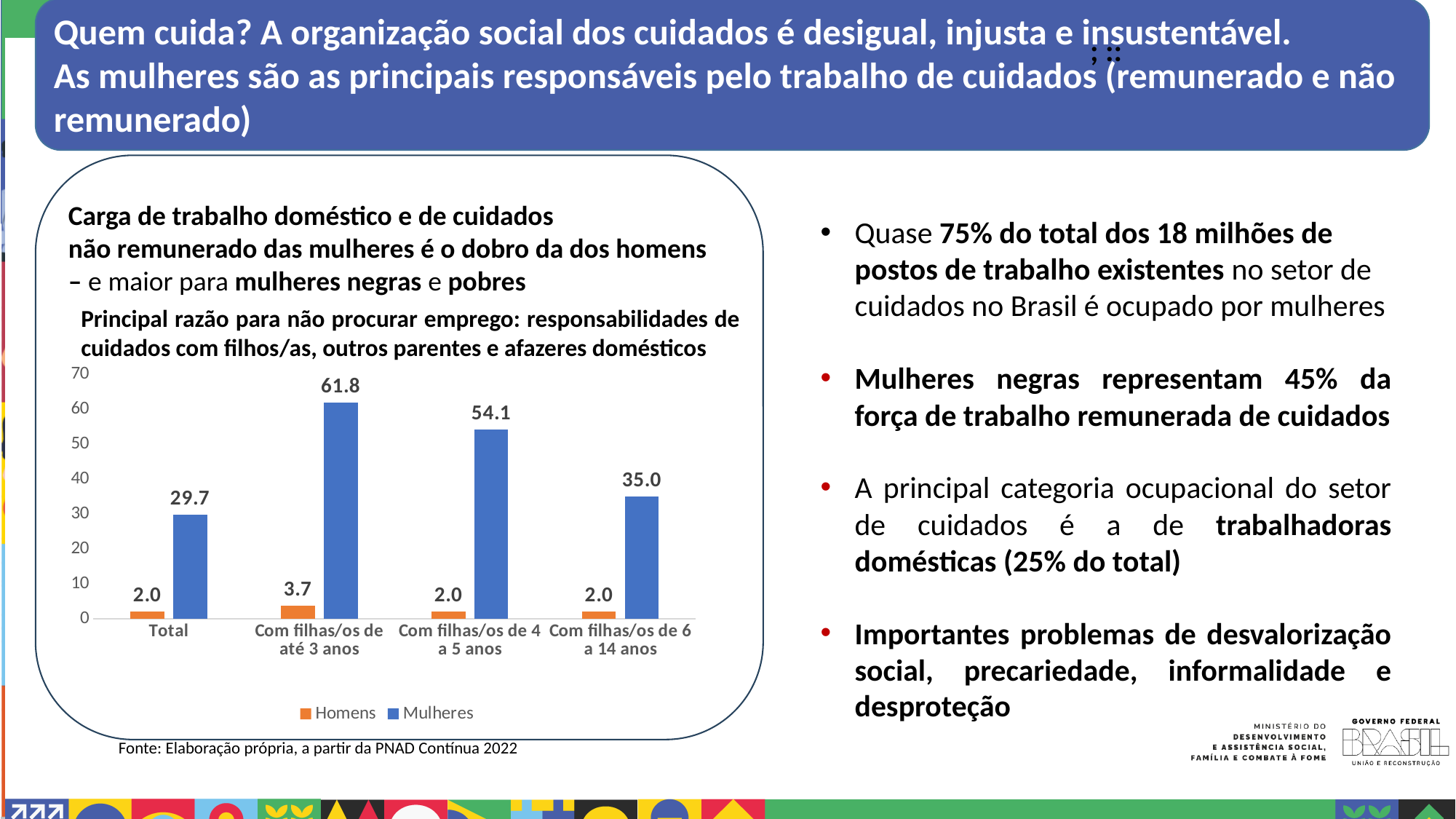
Which category has the highest value for Mulheres? Com filhas/os de até 3 anos Which is larger: the Mulheres value for 'Com filhas/os de 4 a 5 anos' or for 'Com filhas/os de 6 a 14 anos'? Com filhas/os de 4 a 5 anos What type of chart is shown on the slide? Bar chart What is the value for Mulheres in the 'Total' category? 29.7 Is the Mulheres value for 'Com filhas/os de até 3 anos' greater or less than 60? greater How many series does the chart legend list? 2 What is the value for Mulheres in the 'Com filhas/os de até 3 anos' category? 61.8 What is the value for Mulheres in the 'Com filhas/os de 6 a 14 anos' category? 35.0 What is the value for Homens in the 'Com filhas/os de até 3 anos' category? 3.7 Which category has the lowest value for Mulheres? Total How many categories are shown on the x axis of the chart? 4 What is the difference between the Mulheres and Homens values in the 'Com filhas/os de 4 a 5 anos' category? 52.1